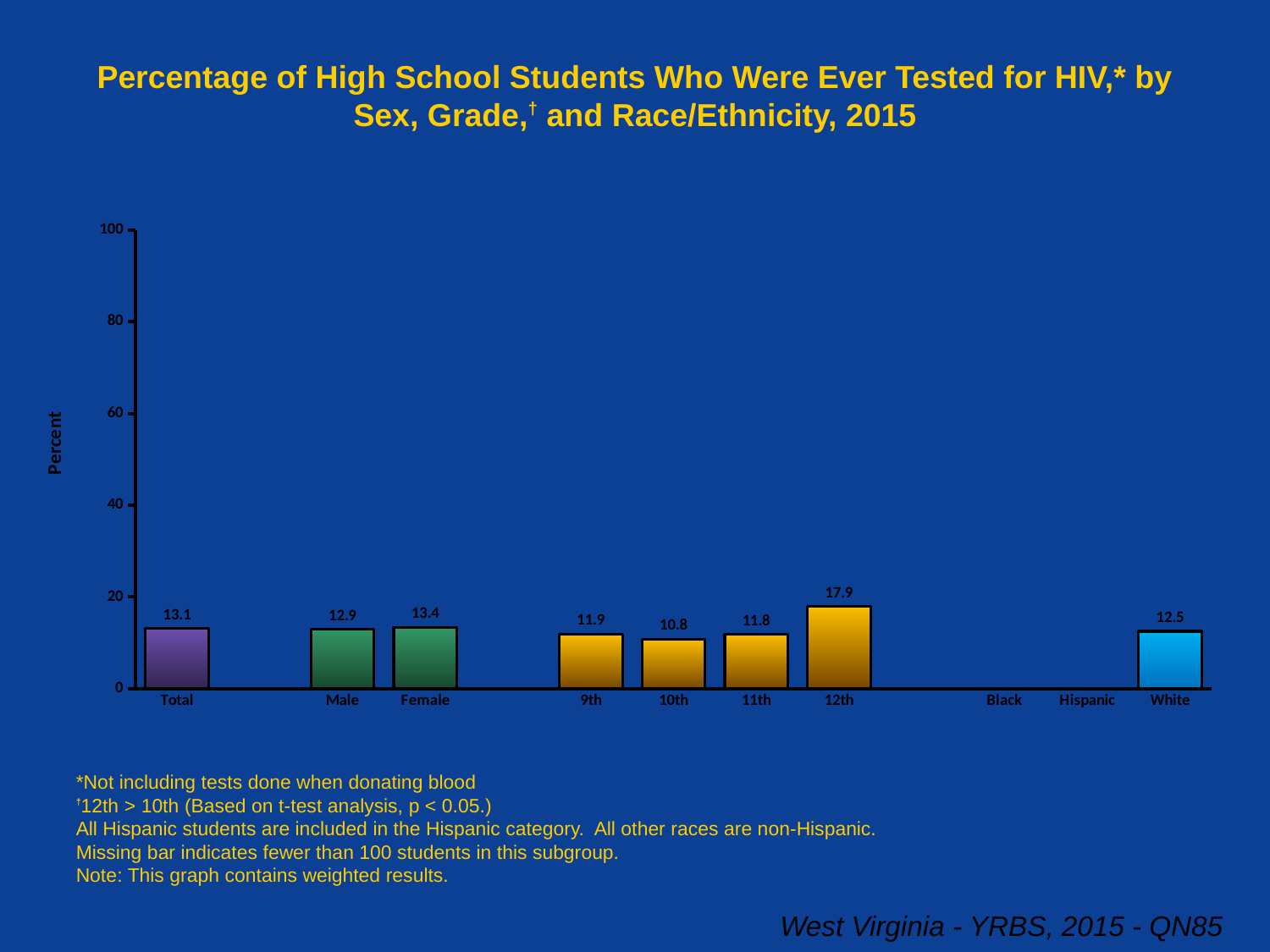
Which category with a bar has the lowest value? 10th Is the value for 12th grade greater or less than 20? less What is the value for 12th grade? 17.9 How many categories are labeled on the x axis? 10 What is the difference between the Female and Male values? 0.5 Which is larger, the value for 9th grade or 11th grade? 9th Which categories on the x axis have no bar shown? Black and Hispanic What is the value for White students? 12.5 What is the difference between the 12th and 10th grade values? 7.1 Which category has the highest value? 12th What kind of chart is shown? bar chart What is the value for Total? 13.1